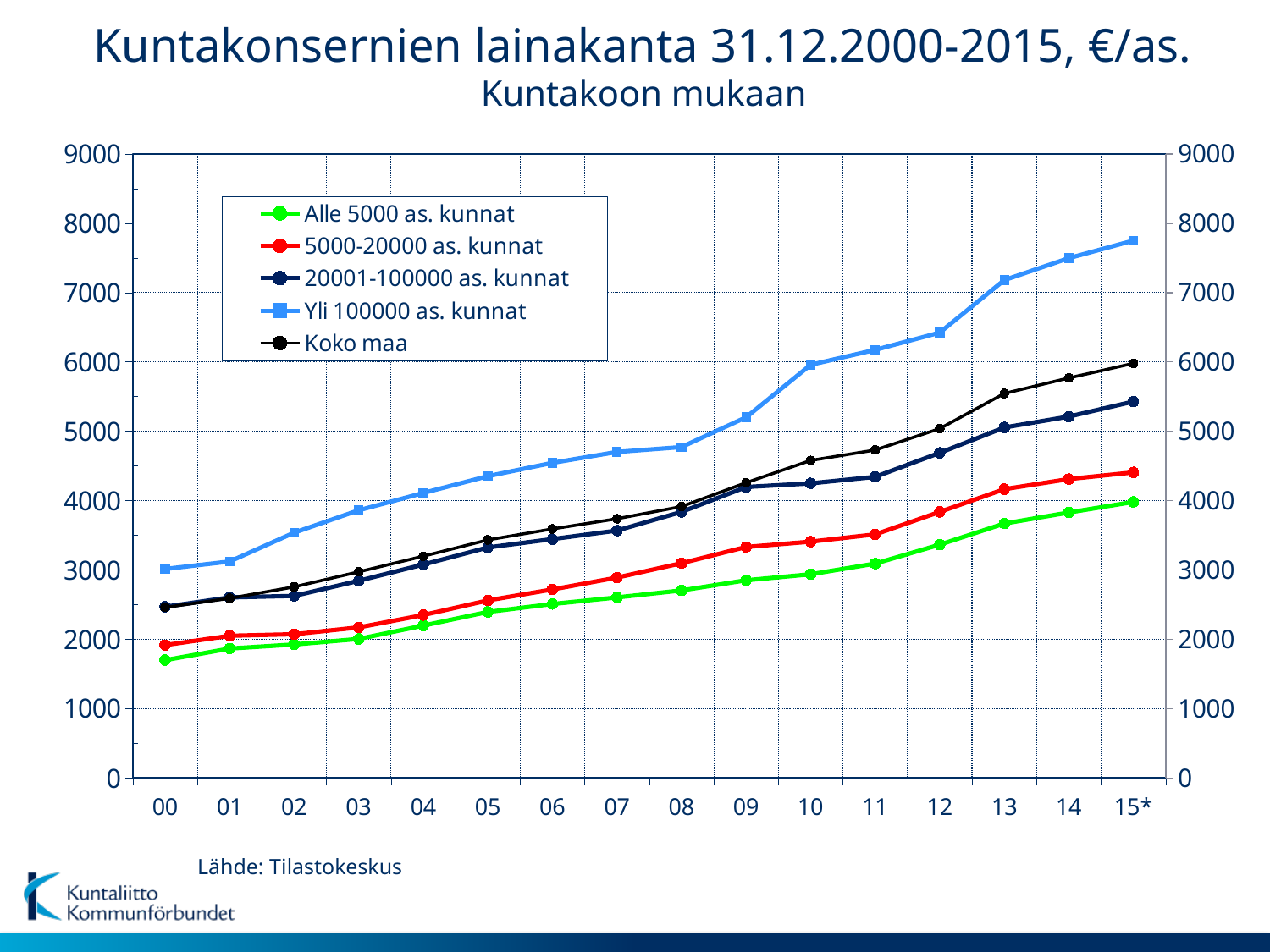
What is the title of the chart? Kuntakonsernien lainakanta 31.12.2000-2015, €/as. What kind of chart is shown on the slide? line chart Do the values for Koko maa rise or fall from 00 to 15*? rise Is the value for Yli 100000 as. kunnat in 15* greater or less than 7000? greater Which series has the highest value in 15*? Yli 100000 as. kunnat How many series does the legend list? 5 Is the value for 5000-20000 as. kunnat in 15* greater or less than 4000? greater How many years are shown along the x axis? 16 Is the value for Yli 100000 as. kunnat in 10 greater or less than 5000? greater Which series has the lowest value in 00? Alle 5000 as. kunnat In 15*, which is larger: Koko maa or 20001-100000 as. kunnat? Koko maa